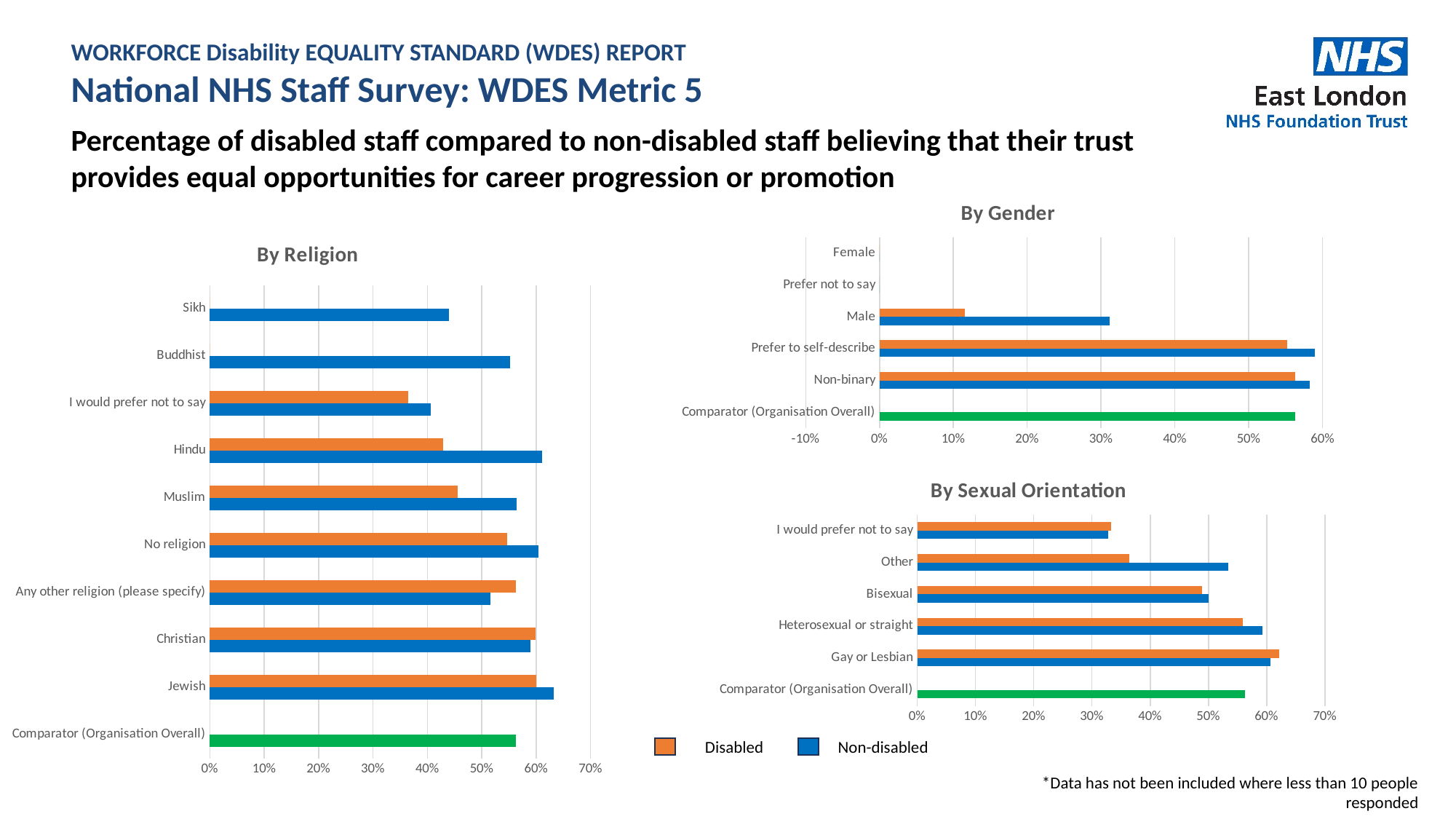
In the 'By Gender' chart, is the Disabled value for Male greater or less than 20%? less In the 'By Sexual Orientation' chart, is the Disabled value for 'I would prefer not to say' greater or less than 40%? less In the 'By Gender' chart, which category has the lowest Disabled value among those with a bar? Male What kind of chart is the 'By Religion' chart? bar chart In the 'By Sexual Orientation' chart, which category has the highest Disabled value? Gay or Lesbian In the 'By Religion' chart, which is larger for Hindu: the Disabled value or the Non-disabled value? Non-disabled In the 'By Religion' chart, is the Disabled value for Hindu greater or less than 50%? less In the 'By Sexual Orientation' chart, which is larger for Other: the Disabled value or the Non-disabled value? Non-disabled What colour is the Comparator (Organisation Overall) bar in the 'By Sexual Orientation' chart? green How many series does the legend list? 2 In the 'By Religion' chart, how many categories are shown on the vertical axis? 10